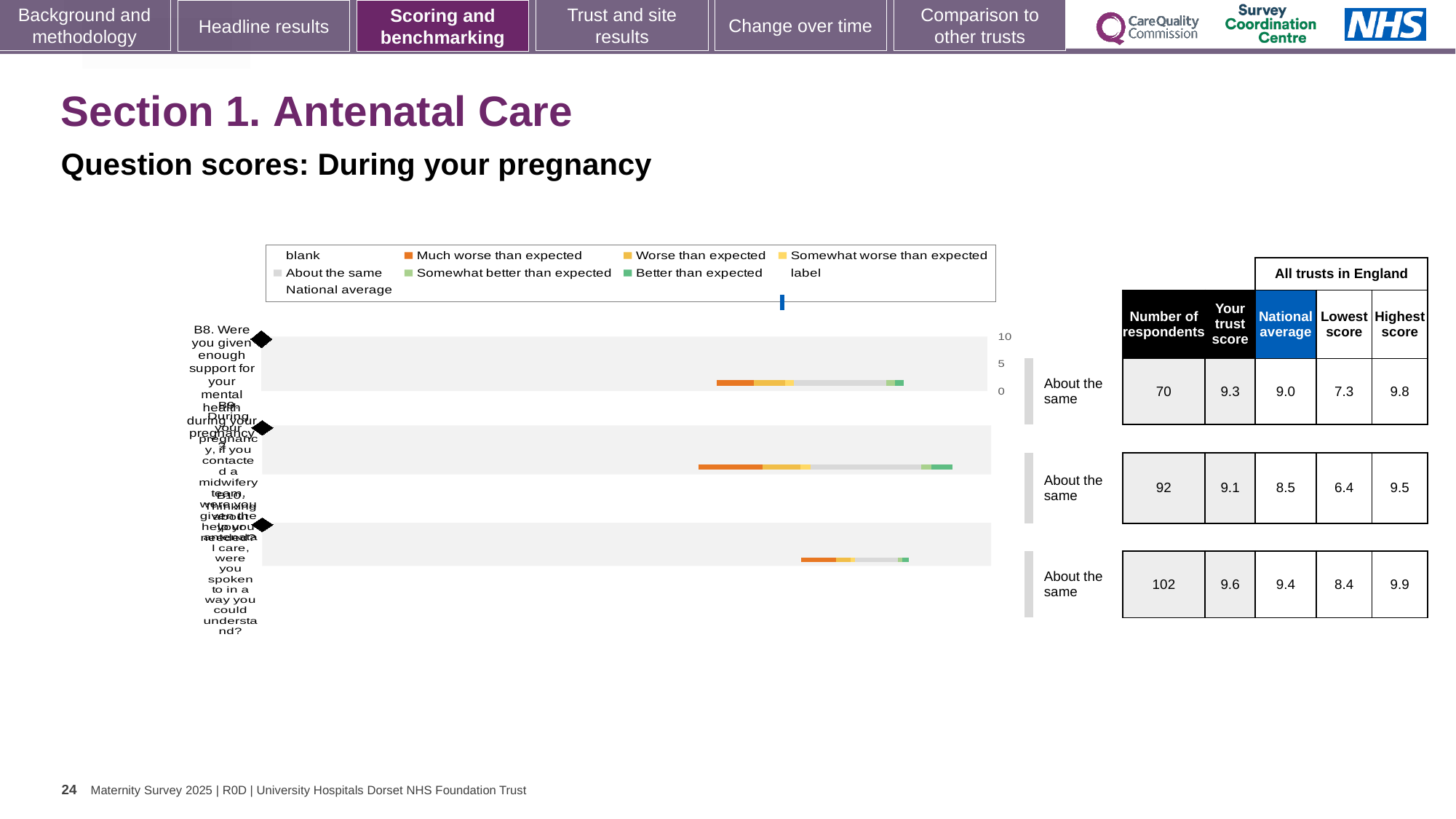
What benchmark category is shown next to each of the three bars? About the same Which question row has the highest 'Your trust score' in the table beside the chart? the third row (9.6) What is the trust's score for the third question row in the table beside the chart? 9.6 Is the national average higher for the first question row or the second question row? the first row (9.0) What is the national average for the second question row in the table beside the chart? 8.5 According to the table beside the chart, how many respondents answered the first question (B8, support for your mental health during pregnancy)? 70 What is the difference between the highest score and the lowest score for the second question row? 3.1 What kind of chart is shown on the slide? bar chart In the chart legend, what colour represents 'Much worse than expected'? orange Which question row has the fewest respondents in the table beside the chart? the first row (70) How many horizontal bars (questions) are plotted in the chart? 3